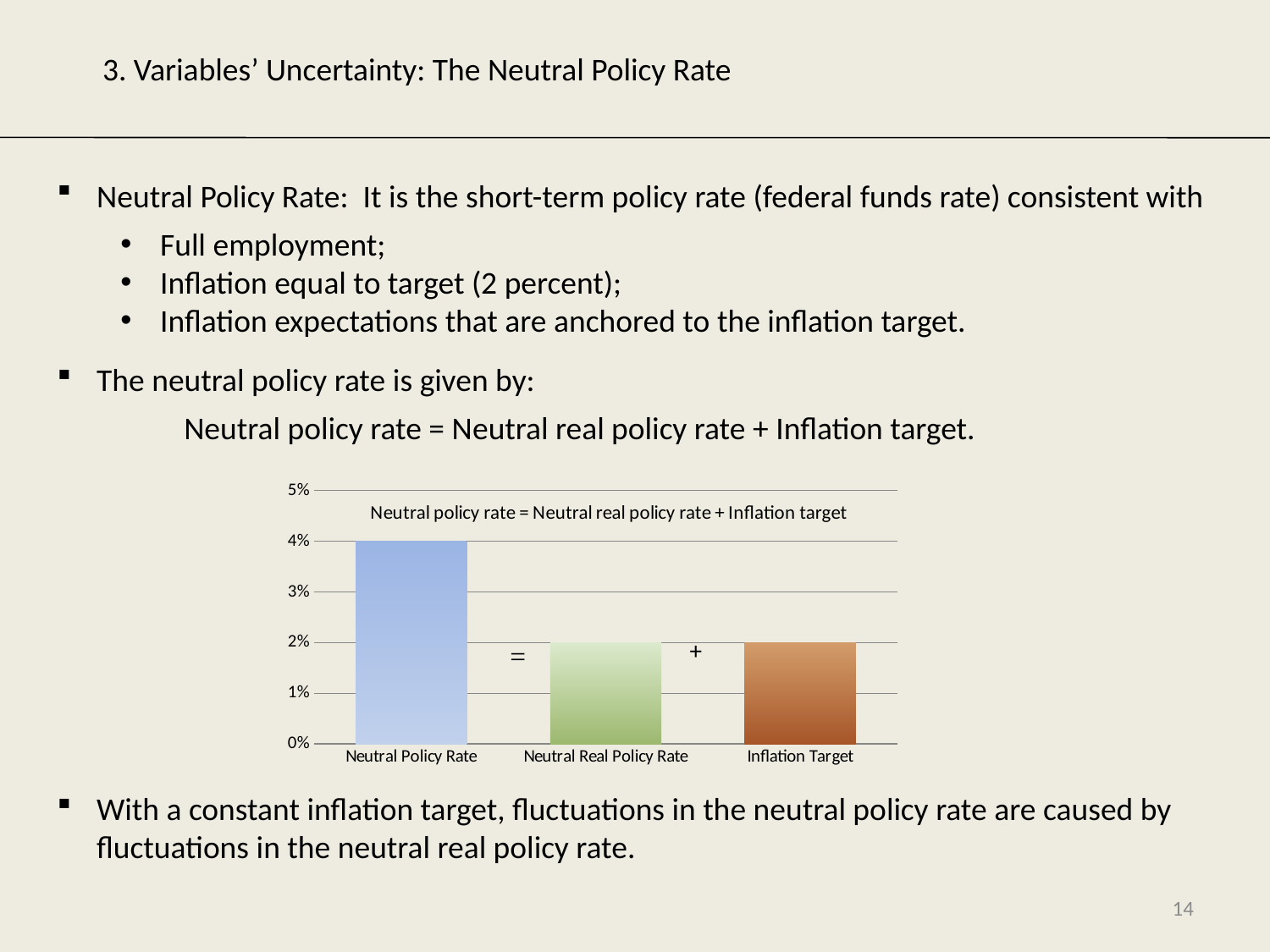
Which is larger, the Neutral Policy Rate or the Inflation Target? Neutral Policy Rate What is the value for Neutral Policy Rate? 4% What is the difference between the Neutral Policy Rate and the Neutral Real Policy Rate? 2% Is the value for Neutral Policy Rate greater or less than 3%? greater What is the difference between the Neutral Policy Rate and the Inflation Target? 2% How many categories are shown on the chart? 3 What is the title of the chart? Neutral policy rate = Neutral real policy rate + Inflation target What kind of chart is shown on the slide? Bar chart Is the value for Neutral Real Policy Rate greater or less than 3%? less What is the value for Neutral Real Policy Rate? 2% Which category has the highest value? Neutral Policy Rate What is the value for Inflation Target? 2%